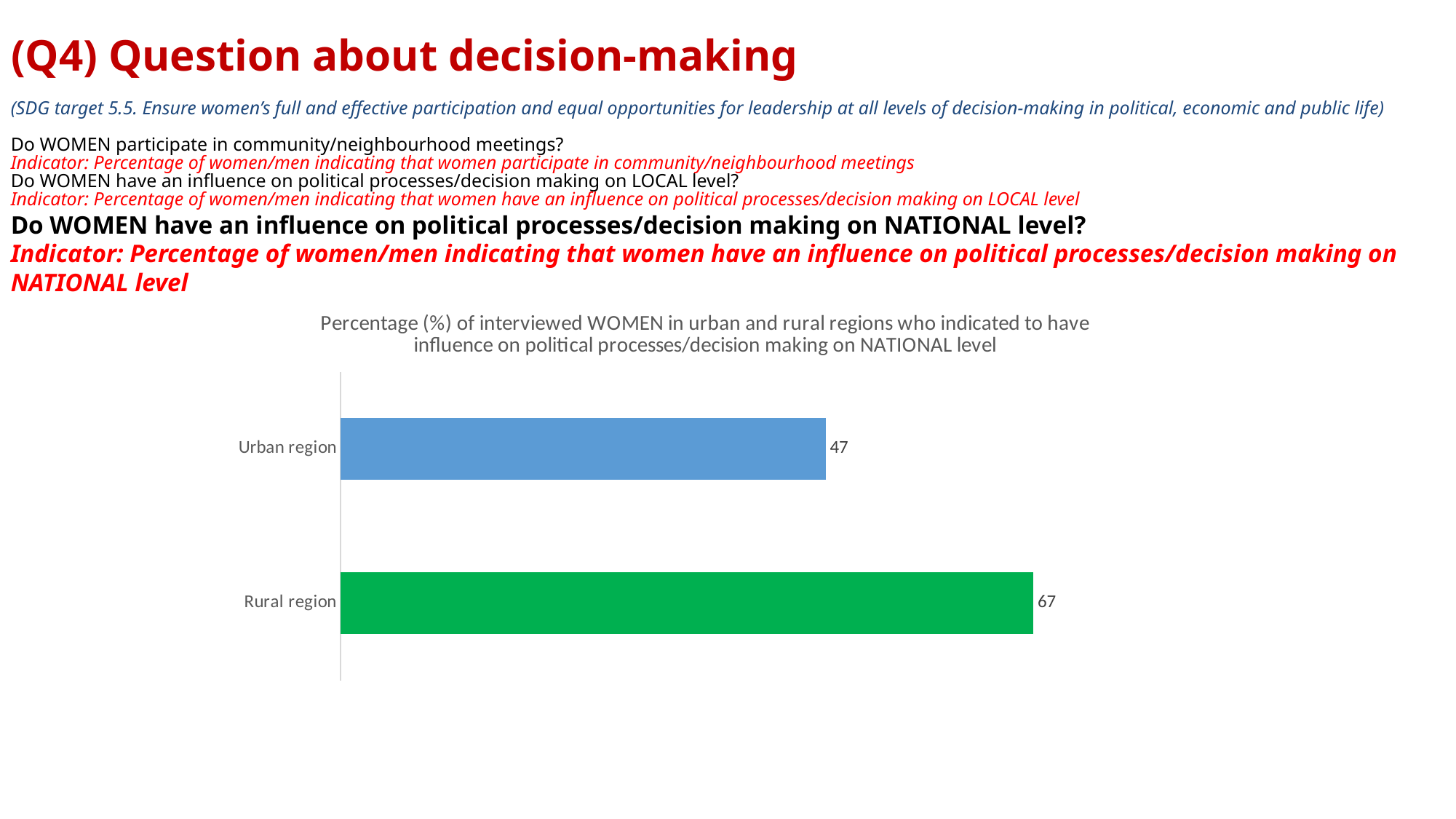
What kind of chart is shown on the slide? Bar chart What is the difference between the values for Rural region and Urban region? 20 How many categories are shown in the chart? 2 What is the value for Urban region? 47 Which is larger, the value for Urban region or the value for Rural region? Rural region What is the value for Rural region? 67 Which region has the highest value? Rural region What colour is the bar for Rural region? Green What colour is the bar for Urban region? Blue Which region has the lowest value? Urban region